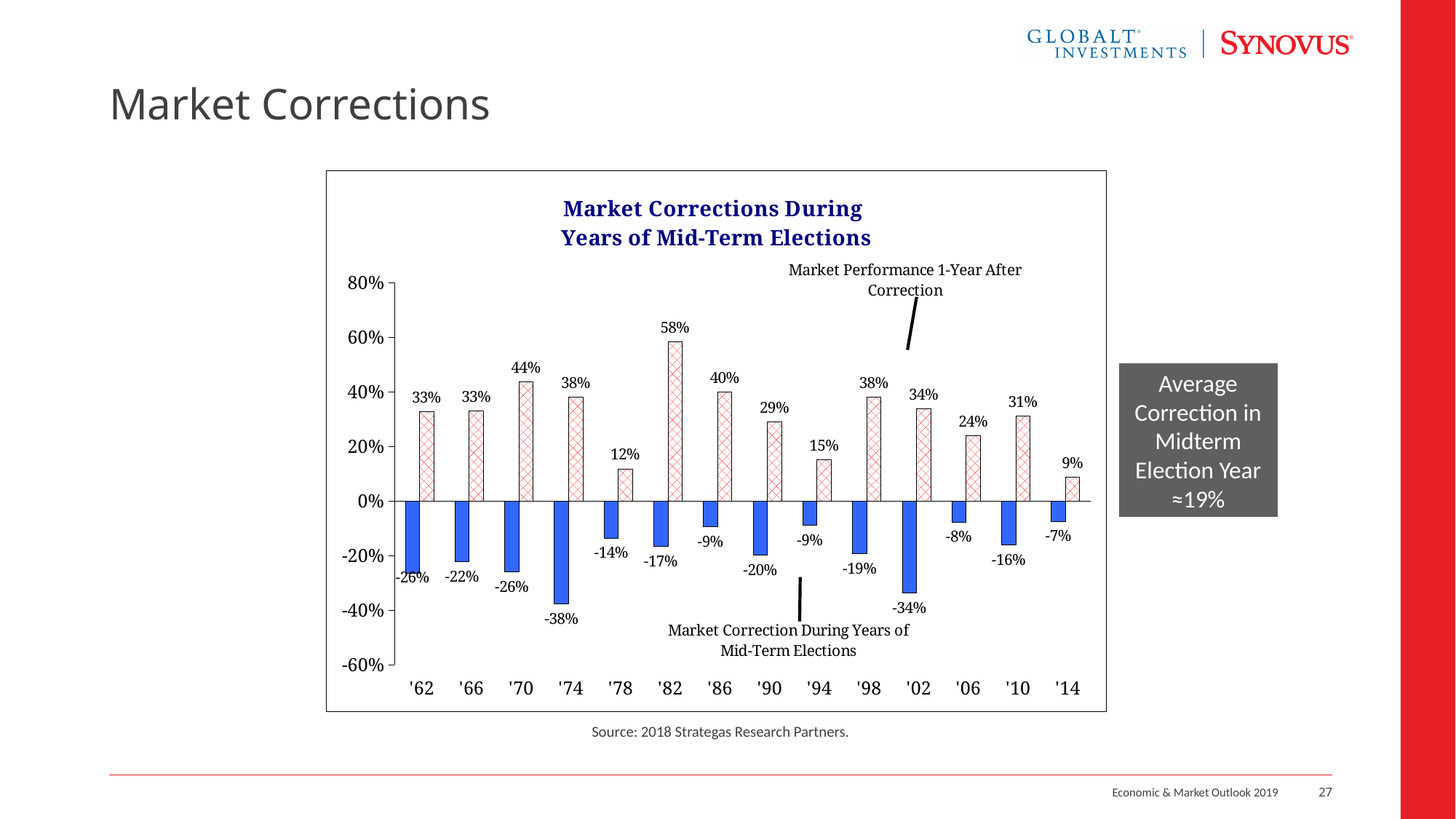
What type of chart is shown on the slide? bar chart How many mid-term election years are plotted on the x axis? 14 How many data series does the chart plot? 2 Which year shows the lowest market performance 1-year after correction? '14 What was the market correction in '14? -7% What is the difference between the 1-year-after performance in '82 (58%) and in '14 (9%)? 49% Which is larger: the 1-year-after performance in '70 or in '06? '70 What was the market correction during the mid-term election year '74? -38% Which year shows the highest market performance 1-year after correction? '82 Which year had the largest (most negative) market correction? '74 According to the callout box on the slide, what is the average correction in a midterm election year? ≈19% What was the market performance 1-year after the correction in '82? 58%